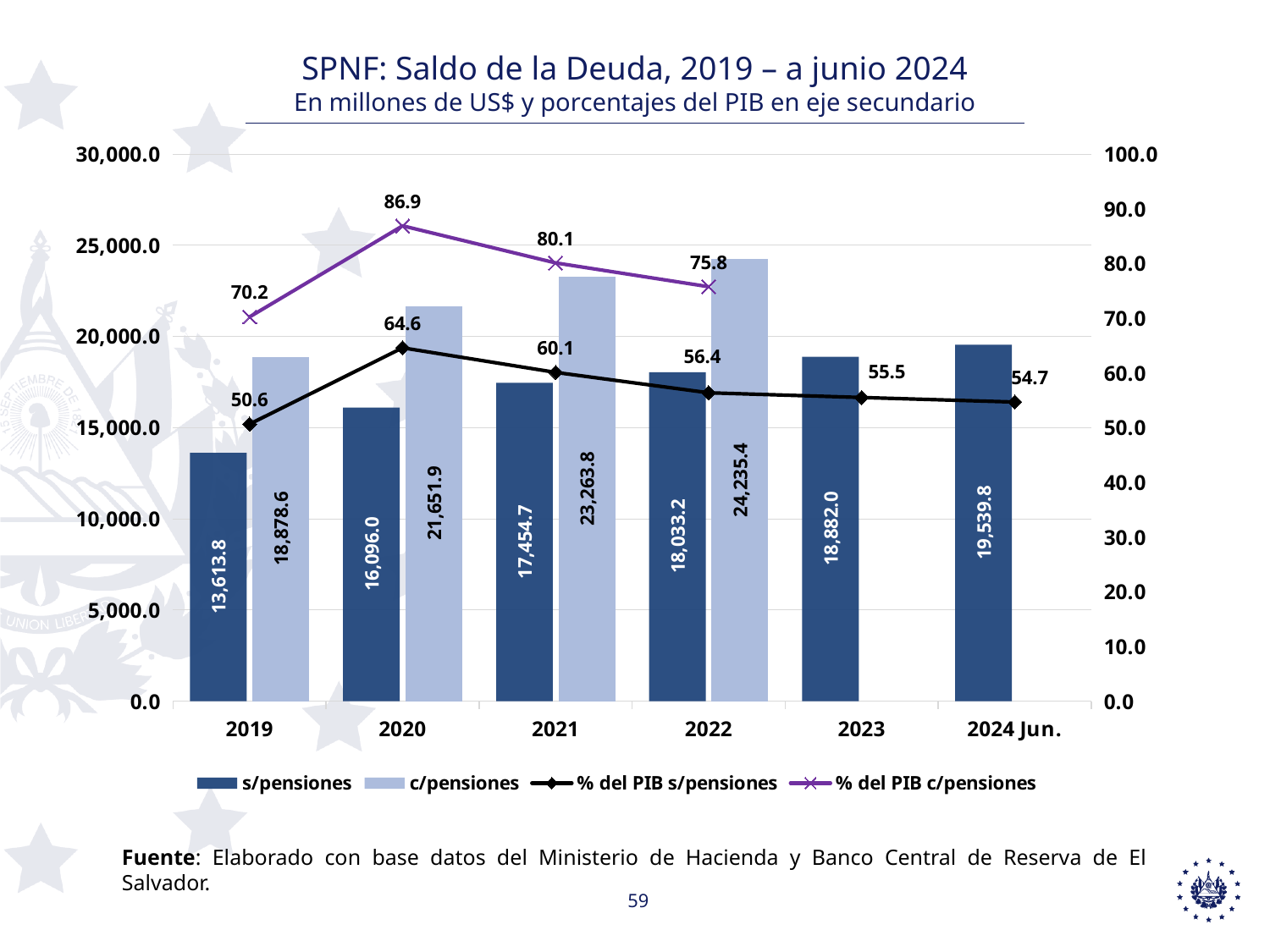
How many series does the legend list? 4 Which year has the lowest % del PIB s/pensiones value? 2019 What is the difference between c/pensiones and s/pensiones in 2019? 5,264.8 What is the value of c/pensiones for 2022? 24,235.4 By how much did % del PIB c/pensiones increase from 2019 to 2020? 16.7 How many years are shown on the x axis? 6 Which is larger, the s/pensiones value for 2023 or for 2022? 2023 What is the value of % del PIB c/pensiones for 2020? 86.9 What is the value of s/pensiones for 2021? 17,454.7 Which year has the highest s/pensiones value? 2024 Jun. Does % del PIB c/pensiones rise or fall from 2020 to 2022? Fall What kind of chart is this? Combined bar and line chart